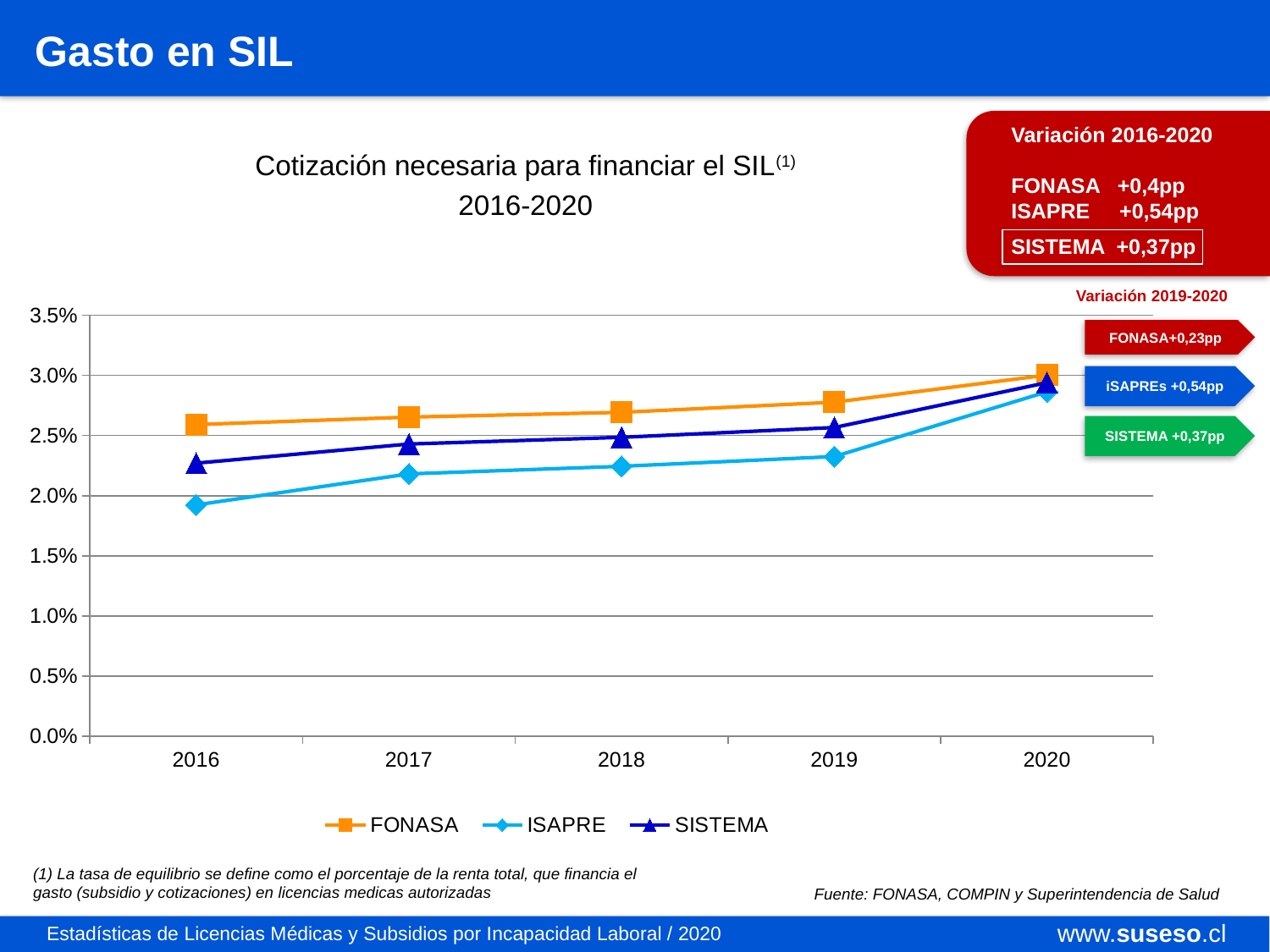
How many years are plotted along the x axis of the chart? 5 How many series does the chart legend list? 3 What is the title of the chart? Cotización necesaria para financiar el SIL(1) 2016-2020 Is the value for ISAPRE in 2019 greater or less than 2.5%? less Is the value for FONASA in 2016 greater or less than 2.5%? greater Which series has the lowest value in 2016? ISAPRE Does the ISAPRE series rise or fall from 2016 to 2020? rise Which series has the highest value in 2016? FONASA Which is larger in 2019, the value for FONASA or the value for ISAPRE? FONASA What kind of chart is shown on the slide? line chart Is the value for SISTEMA in 2016 greater or less than 2.5%? less